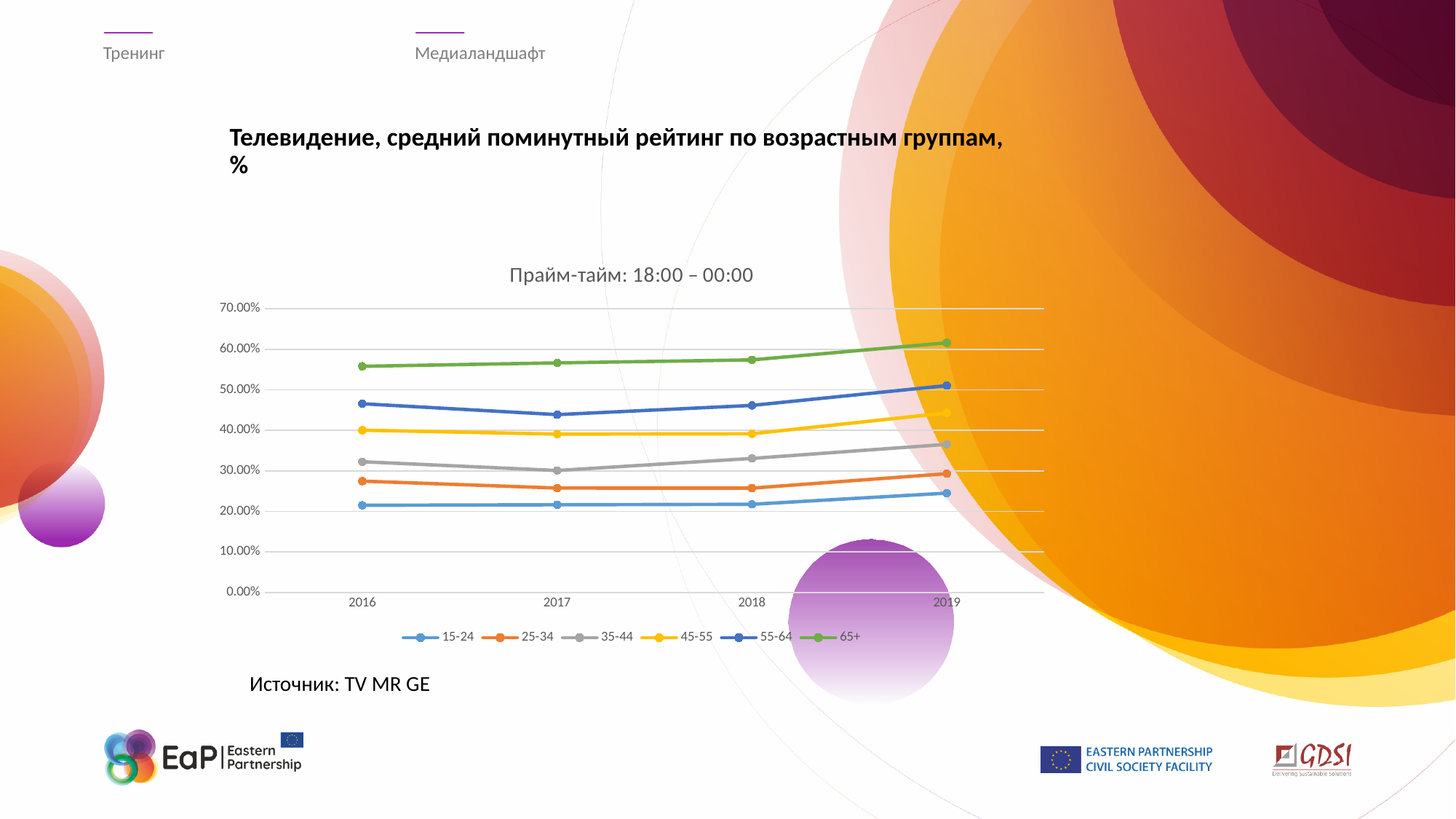
Which age group has the lowest rating in every year shown? 15-24 Is the value for 55-64 in 2017 greater or less than 50.00%? less How many series does the legend list? 6 What is the title shown directly above the chart? Прайм-тайм: 18:00 – 00:00 Is the value for 45-55 in 2019 greater or less than 40.00%? greater Does the rating for the 65+ group rise or fall from 2016 to 2019? rise Is the value for 15-24 in 2019 greater or less than 30.00%? less Which age group has the highest rating in every year shown? 65+ What kind of chart is shown on the slide? line chart How many years are shown on the x axis? 4 Which is larger in 2018, the value for 35-44 or the value for 25-34? 35-44